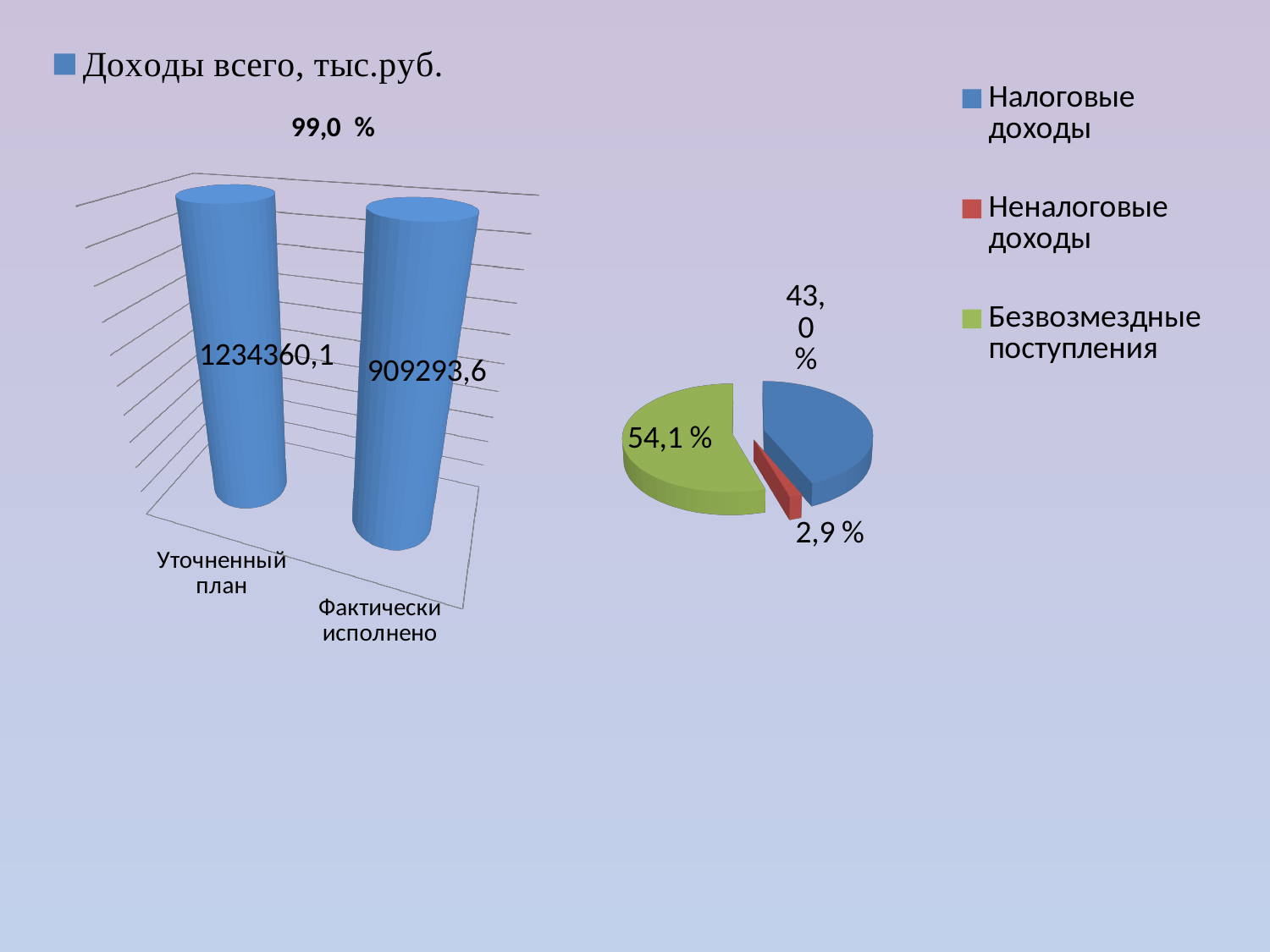
On the bar chart titled "Доходы всего, тыс.руб.", what is the value for "Уточненный план"? 1234360,1 What kind of chart is the chart on the left of the slide? Bar chart On the bar chart titled "Доходы всего, тыс.руб.", how many categories are shown? 2 On the pie chart on the right, which slice is the smallest? Неналоговые доходы On the bar chart titled "Доходы всего, тыс.руб.", what percentage is printed above the bars? 99,0 % On the bar chart titled "Доходы всего, тыс.руб.", what is the difference between the values for "Уточненный план" and "Фактически исполнено"? 325066,5 On the pie chart on the right, what is the difference between the shares of "Безвозмездные поступления" and "Налоговые доходы"? 11,1 % On the bar chart titled "Доходы всего, тыс.руб.", which category has the higher value? Уточненный план On the pie chart on the right, what share does "Безвозмездные поступления" have? 54,1 % On the bar chart titled "Доходы всего, тыс.руб.", what is the value for "Фактически исполнено"? 909293,6 On the pie chart on the right, how many entries does the legend list? 3 On the pie chart on the right, what share does "Налоговые доходы" have? 43,0 %